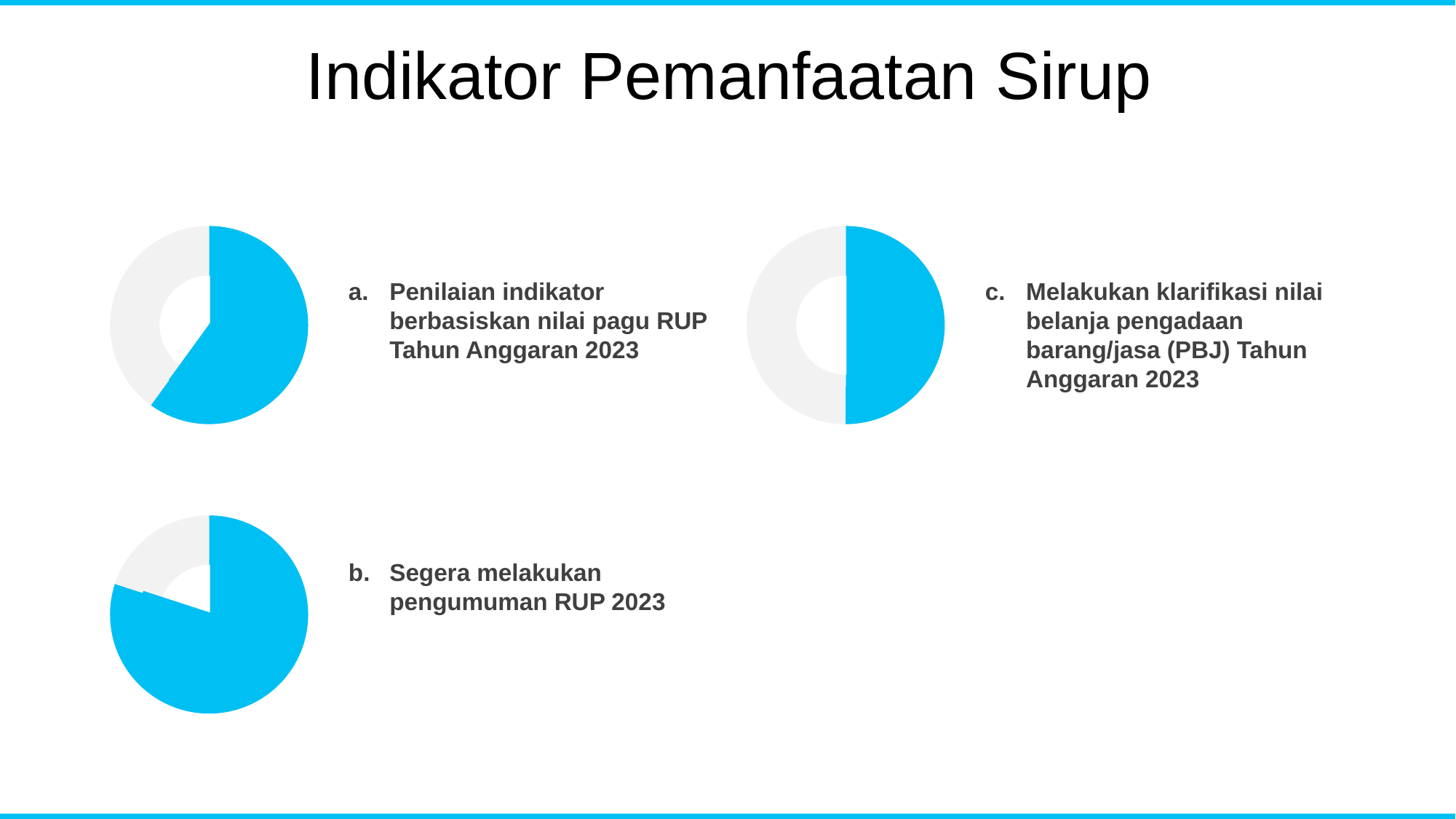
Which of the three charts has the smallest blue slice? the top-right chart (item c) In the bottom-left chart next to item b, which slice is larger, the blue one or the grey one? blue What kind of chart is the top-left chart next to item a? doughnut chart In the top-left chart next to item a, which slice is larger, the blue one or the grey one? blue What kind of chart is the top-right chart next to item c? doughnut chart Which of the three charts has the largest blue slice? the bottom-left chart (item b) How many slices does the top-left chart next to item a have? 2 How many doughnut charts are shown on the slide? 2 How many slices does the bottom-left chart next to item b have? 2 What kind of chart is the bottom-left chart next to item b? pie chart What colour is the larger slice in the bottom-left chart next to item b? blue How many slices does the top-right chart next to item c have? 2